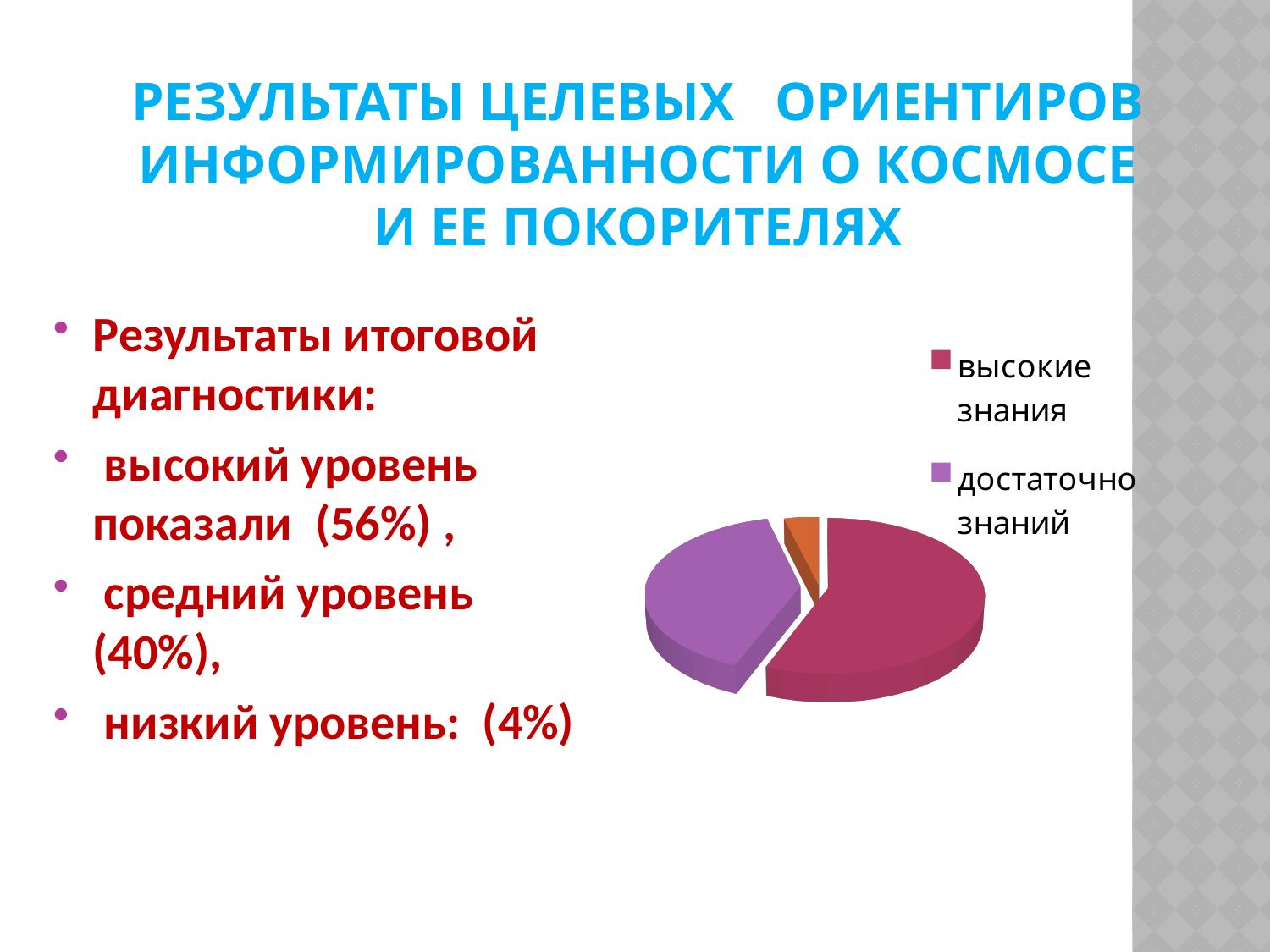
Which legend category has the largest slice of the pie chart? высокие знания What colour is the slice for высокие знания? dark red Which slice is larger: высокие знания or достаточно знаний? высокие знания What kind of chart is shown on the slide? pie chart How many entries are readable in the pie chart's legend? 2 What colour is the slice for достаточно знаний? purple How many slices does the pie chart have? 3